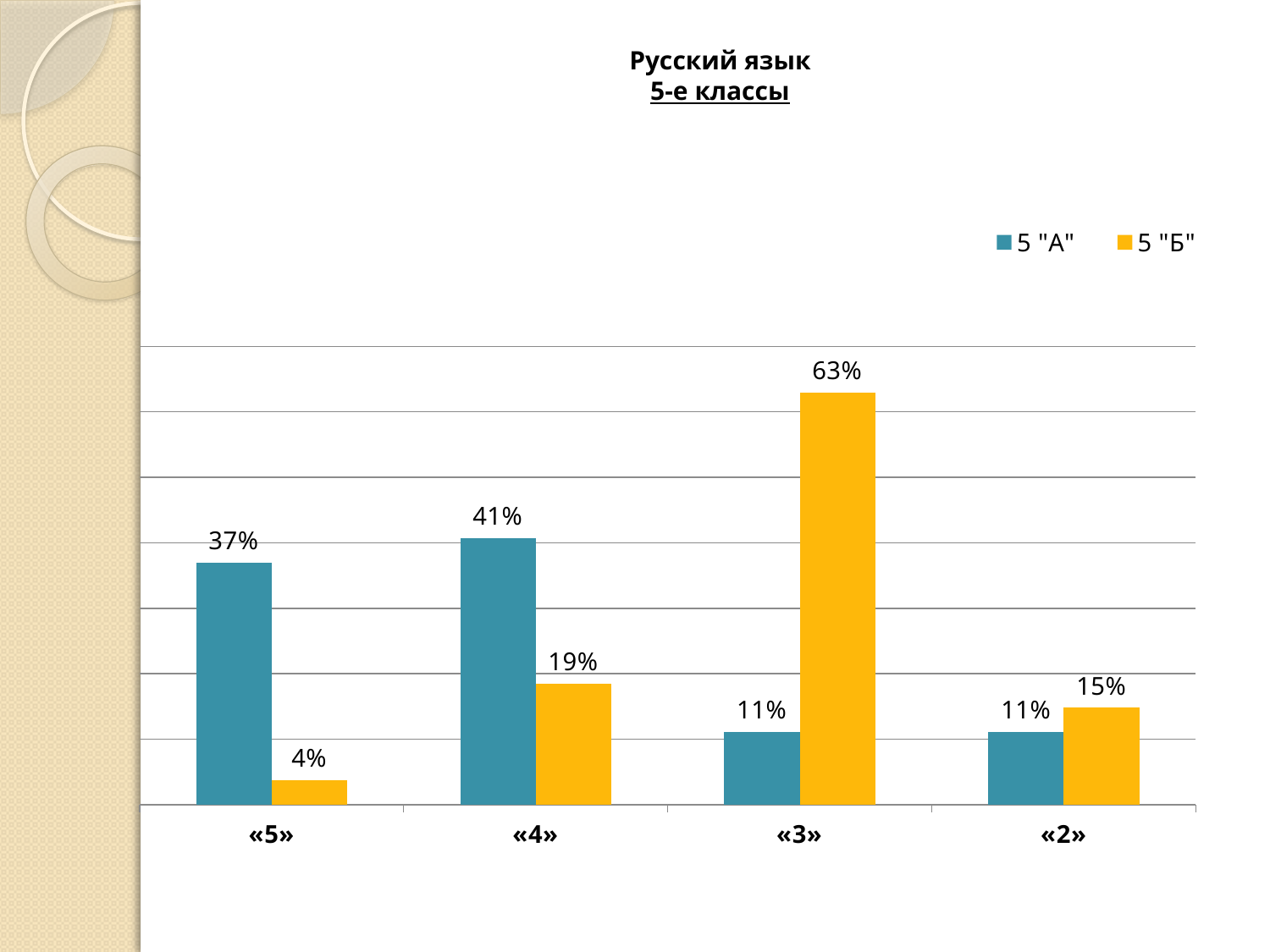
Which category has the highest value for the 5 "А" series? «4» What is the value for 5 "Б" in the «3» category? 63% In the «4» category, which series has the larger value, 5 "А" or 5 "Б"? 5 "А" What is the value for 5 "Б" in the «5» category? 4% What is the difference between the 5 "Б" and 5 "А" values in the «3» category? 52% What kind of chart is shown on the slide? Bar chart What is the value for 5 "А" in the «5» category? 37% What is the title of the chart? Русский язык 5-е классы How many series does the legend list? 2 Which category has the lowest value for the 5 "Б" series? «5» What is the value for 5 "А" in the «2» category? 11% How many categories are shown on the x axis? 4